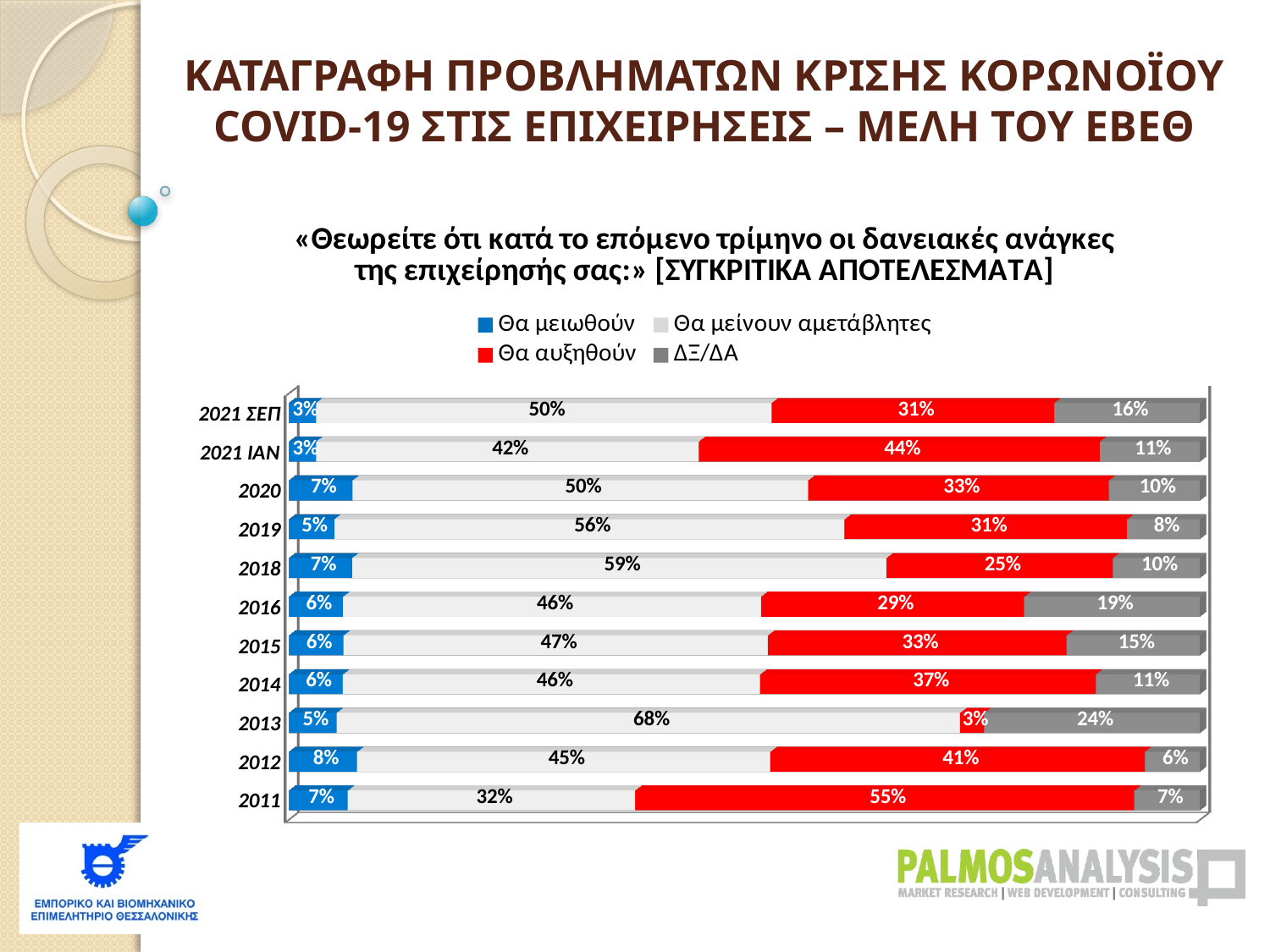
What kind of chart is shown on the slide? Stacked bar chart What is the value for "ΔΞ/ΔΑ" in 2021 ΣΕΠ? 16% What is the difference between the "Θα αυξηθούν" values for 2021 ΙΑΝ and 2021 ΣΕΠ? 13% How many series does the legend list? 4 Which category has the highest value for "ΔΞ/ΔΑ"? 2013 Which category has the lowest value for "Θα αυξηθούν"? 2013 Which category has the highest value for "Θα αυξηθούν"? 2011 How many categories (years/periods) are shown on the chart? 11 What is the total of the stacked bar for 2012? 100% What is the value for "Θα αυξηθούν" in 2011? 55% Which is larger: the "Θα μείνουν αμετάβλητες" value for 2018 or for 2019? 2018 What is the value for "Θα μείνουν αμετάβλητες" in 2013? 68%